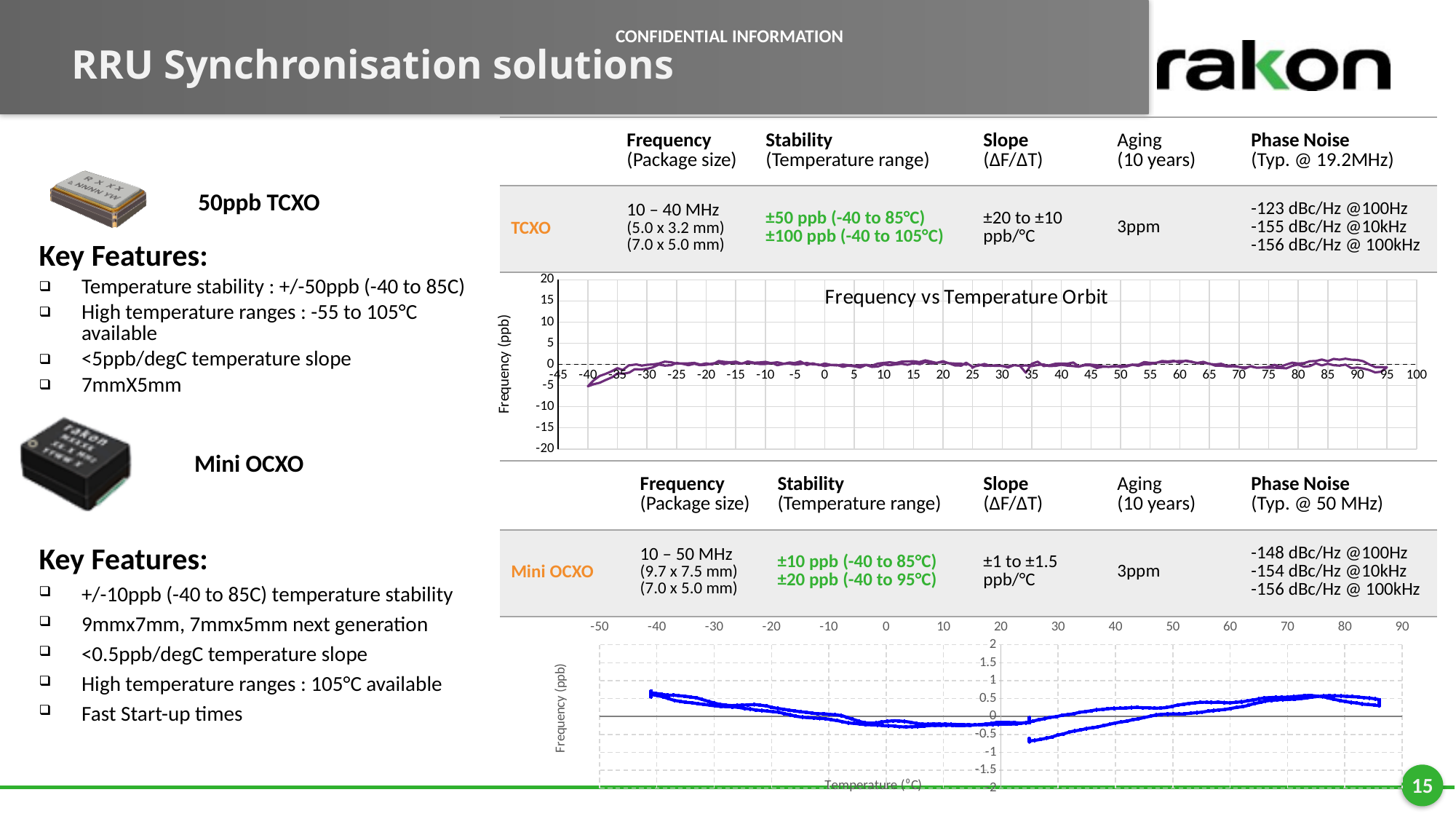
In the bottom chart below the Mini OCXO table, is the value at -40 greater or less than 0? greater In the top chart titled "Frequency vs Temperature Orbit", is the value at 50 greater or less than 5? less In the bottom chart below the Mini OCXO table, do the values rise or fall as temperature goes from -40 to 0? fall What kind of chart is the bottom chart below the Mini OCXO table? line chart In the bottom chart below the Mini OCXO table, do the values rise or fall as temperature goes from 30 to 70? rise What is the title of the top chart? Frequency vs Temperature Orbit What kind of chart is the top chart titled "Frequency vs Temperature Orbit"? line chart In the bottom chart below the Mini OCXO table, is the value at -40 greater or less than 1? less What is the y-axis label of the top chart titled "Frequency vs Temperature Orbit"? Frequency (ppb)